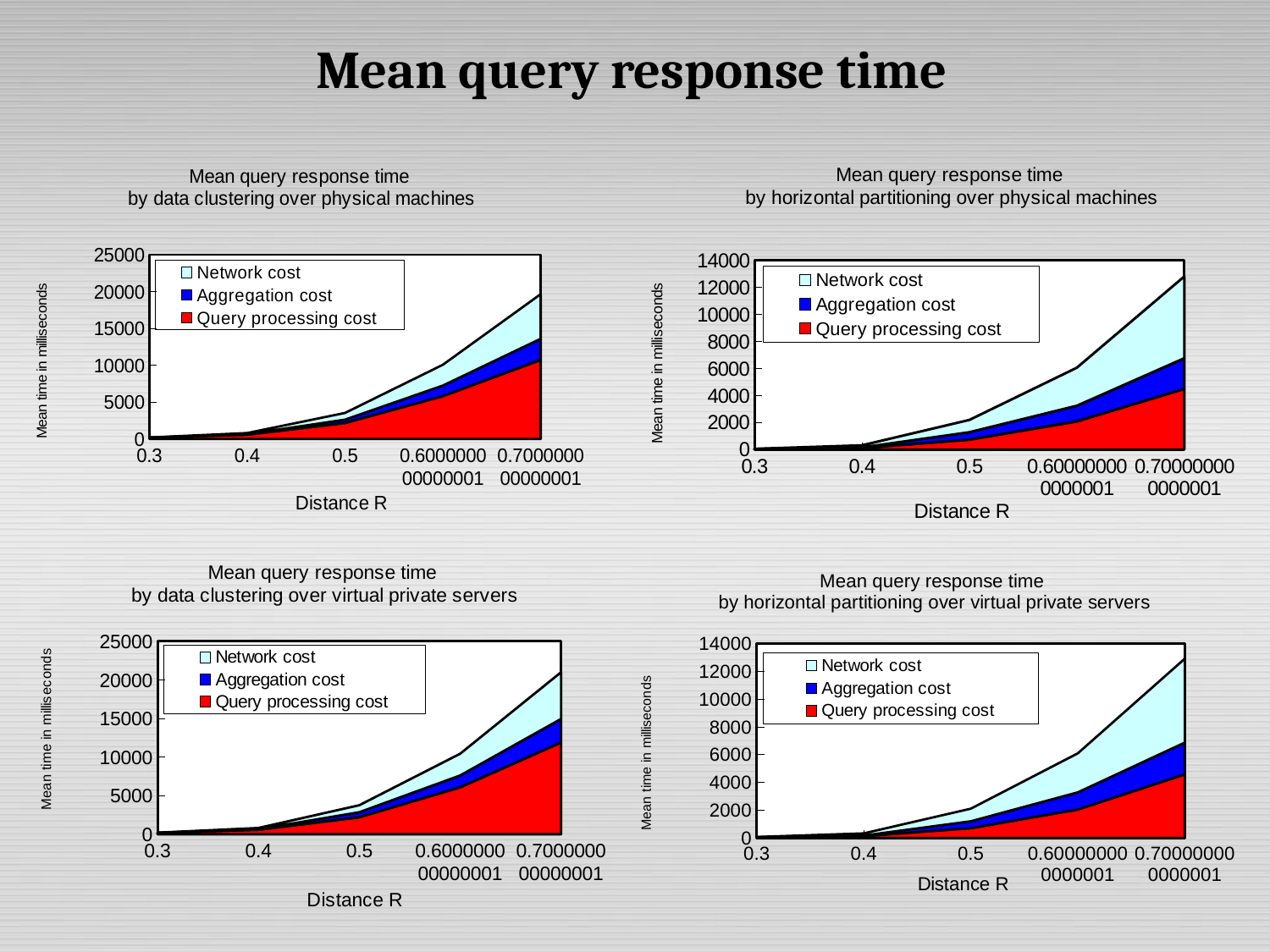
In the bottom-left chart, 'Mean query response time by data clustering over virtual private servers', is the total stacked value at Distance R 0.7 greater or less than 15000? greater In the top-left chart, 'Mean query response time by data clustering over physical machines', which Distance R value has the highest total mean time? 0.700000000000001 In the bottom-right chart, 'Mean query response time by horizontal partitioning over virtual private servers', is the total stacked value at Distance R 0.4 greater or less than 2000? less How many series does the legend list in the top-right chart, 'Mean query response time by horizontal partitioning over physical machines'? 3 How many Distance R values are plotted along the x axis of the bottom-left chart, 'Mean query response time by data clustering over virtual private servers'? 5 In the top-right chart, 'Mean query response time by horizontal partitioning over physical machines', is the total stacked value at Distance R 0.5 greater or less than 4000? less Which series is shown in red in the legend of the bottom-left chart, 'Mean query response time by data clustering over virtual private servers'? Query processing cost What is the y-axis title of the top-right chart, 'Mean query response time by horizontal partitioning over physical machines'? Mean time in milliseconds What kind of chart is the top-left chart, 'Mean query response time by data clustering over physical machines'? Stacked area chart In the bottom-right chart, 'Mean query response time by horizontal partitioning over virtual private servers', does the total mean time rise or fall as Distance R increases? Rises